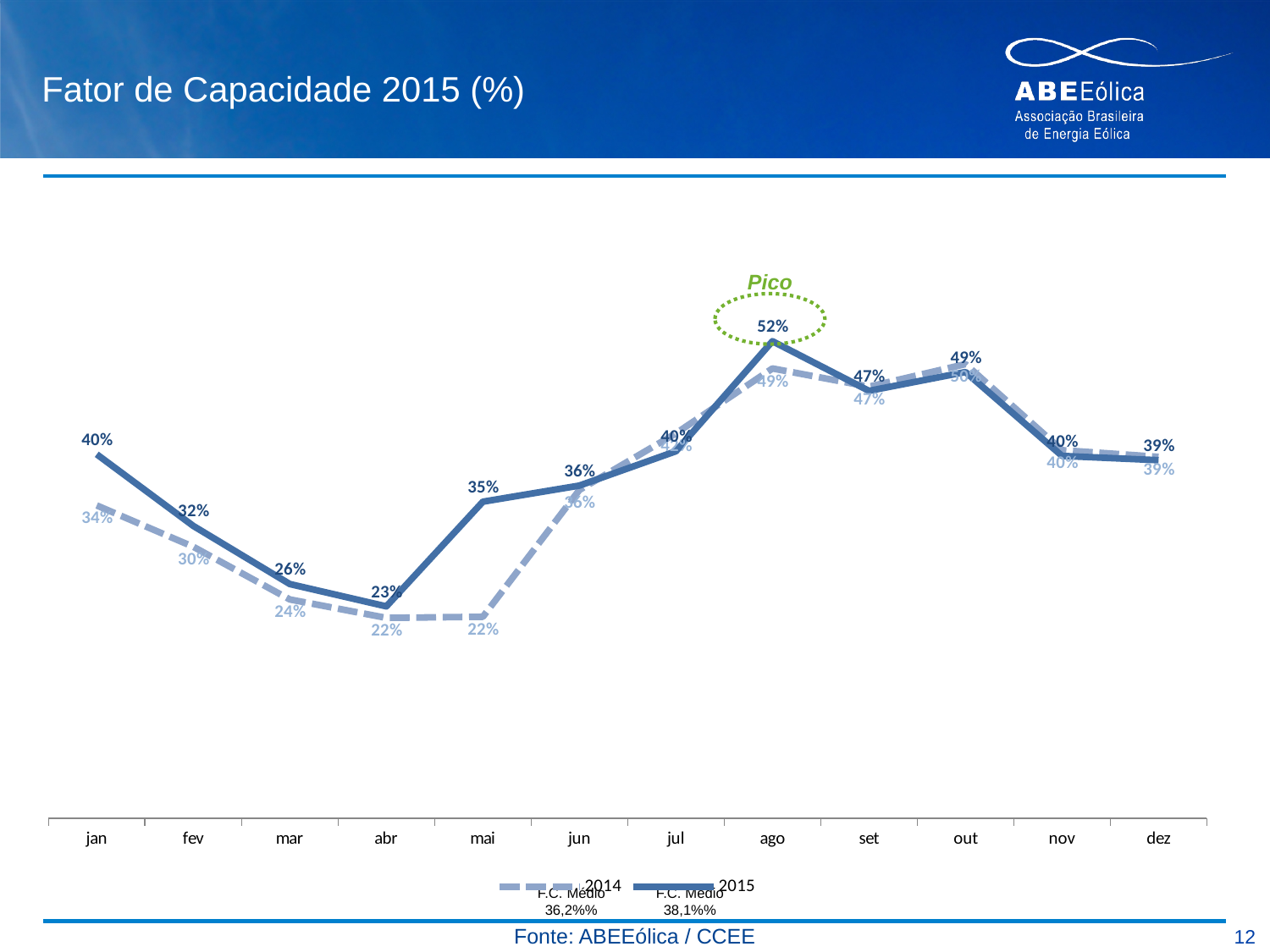
In which month does the 2015 series reach its highest value? ago What is the difference between the 2015 and 2014 values in mai (May)? 13% What label is written inside the green dotted circle above the August point? 52% What is the 2015 capacity factor for abr (April)? 23% How many months are plotted along the x axis? 12 In which month does the 2015 series reach its lowest value? abr How many series does the legend list? 2 What is the 2014 capacity factor for jan (January)? 34% Which series has the higher value in jan (January), 2014 or 2015? 2015 What is the 2015 capacity factor for ago (August)? 52% What is the 2014 capacity factor for mai (May)? 22% What type of chart is shown on the slide? line chart